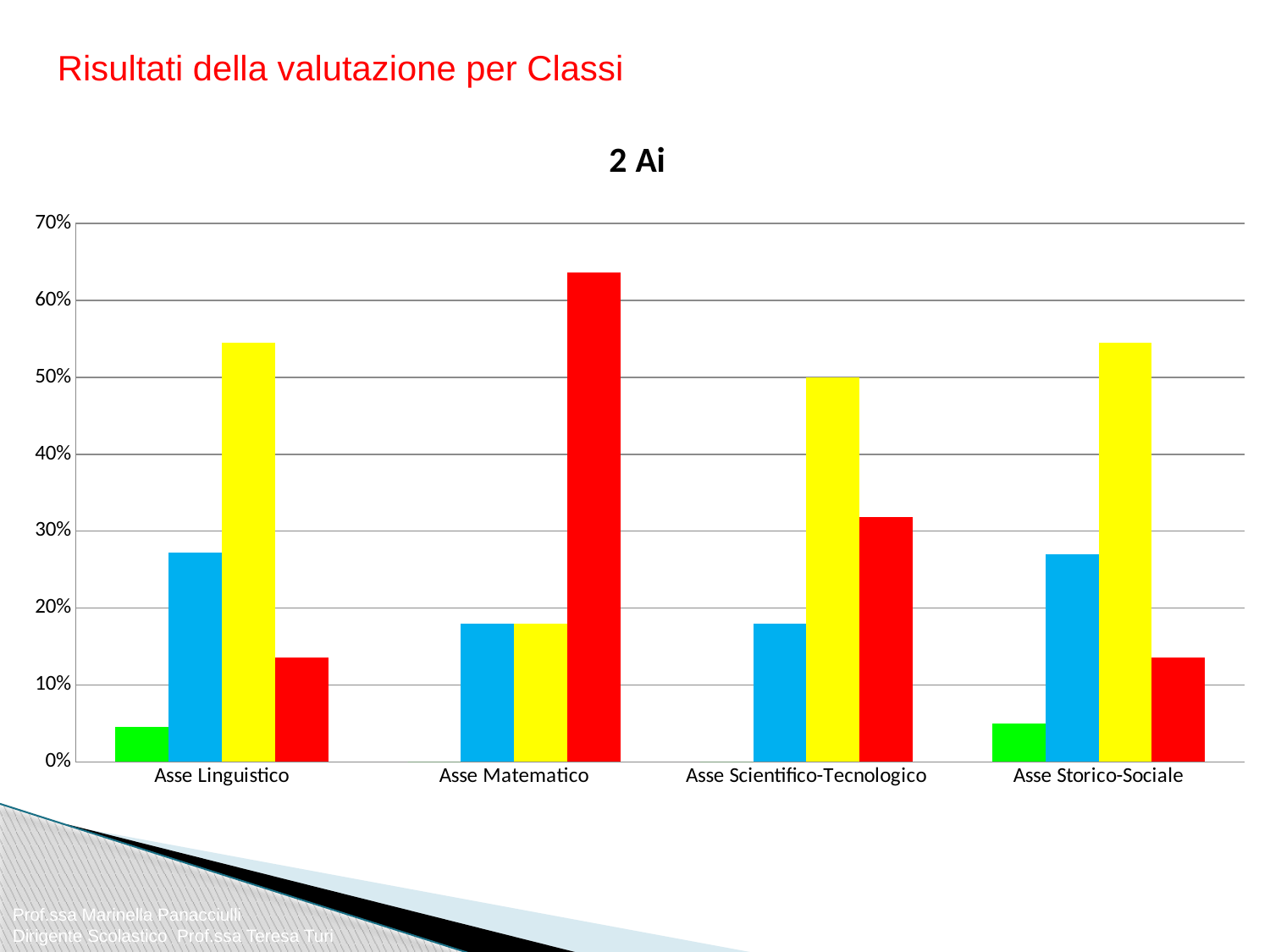
Which category has the tallest bar in the chart? Asse Matematico How many categories are shown on the x axis of the chart? 4 What is the title of the chart? 2 Ai Is the value of the green bar for Asse Linguistico greater or less than 10%? less For Asse Matematico, which is larger: the red bar or the yellow bar? the red bar How many different bar colours are used in the chart? 4 Which category has the lowest yellow bar? Asse Matematico Is the value of the blue bar for Asse Matematico greater or less than 20%? less What kind of chart is shown on the slide? bar chart Is the value of the red bar for Asse Scientifico-Tecnologico greater or less than 30%? greater